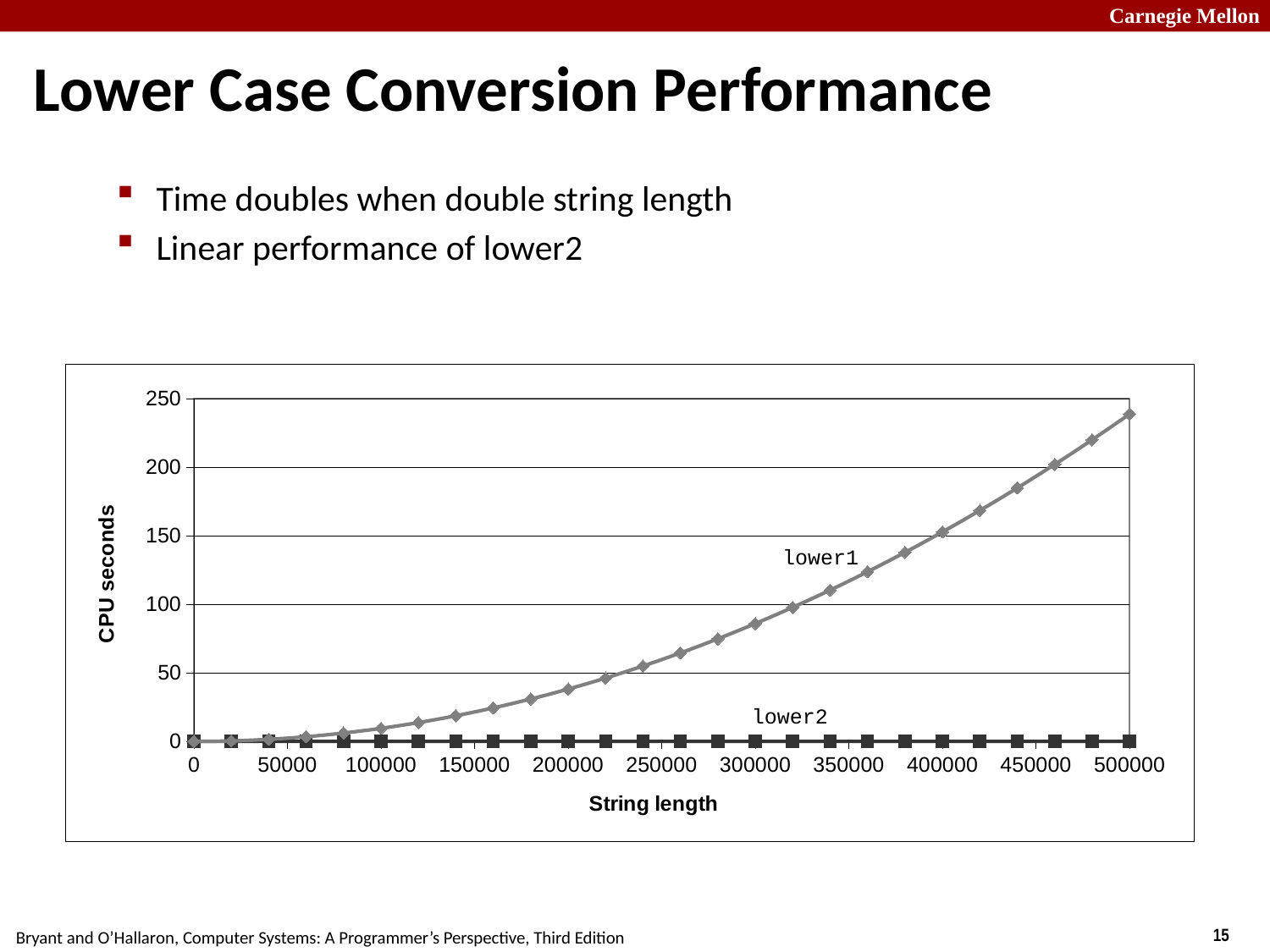
What is the label of the y axis? CPU seconds What are the names of the two series plotted in the chart? lower1 and lower2 Which series reaches the highest CPU seconds value in the chart? lower1 At a string length of 500000, which series has the larger CPU seconds value, lower1 or lower2? lower1 Is the value of lower1 at a string length of 300000 greater or less than 100? less How many data series are plotted in the chart? 2 Is the value of lower1 at a string length of 500000 greater or less than 200? greater Is the value of lower1 at a string length of 200000 greater or less than 50? less Does the CPU seconds value for lower1 rise or fall as string length increases? rise What kind of chart is shown on the slide? line chart